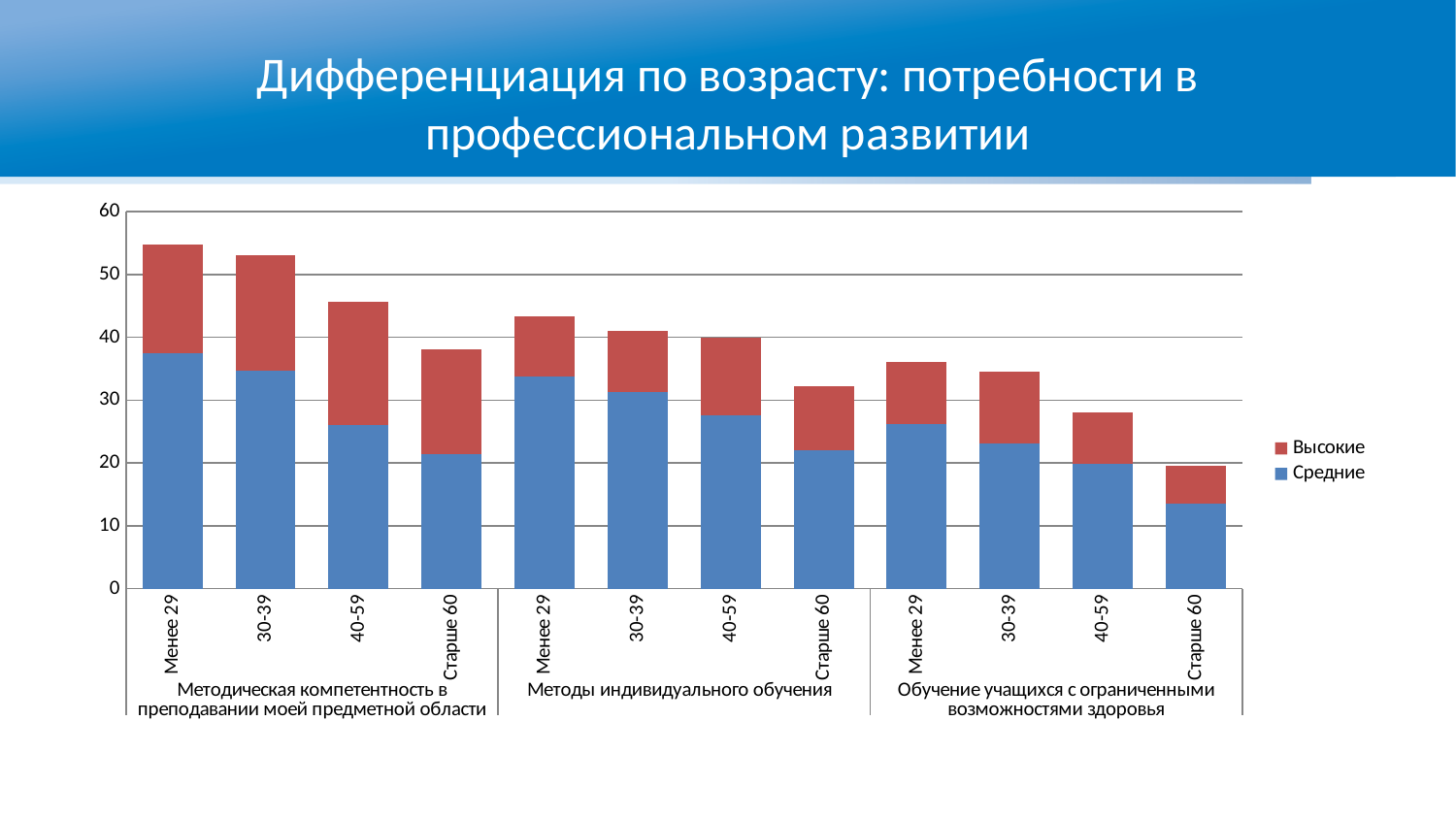
Within each category group, do the total bar heights rise or fall as the age group increases from Менее 29 to Старше 60? fall Is the total height of the bar for Менее 29 in Методическая компетентность в преподавании моей предметной области greater or less than 50? greater How many category groups are shown along the x axis? 3 How many stacked bars are plotted in the chart? 12 Which bar is the shortest in the chart? Старше 60 in Обучение учащихся с ограниченными возможностями здоровья Which colour represents the Средние series in the chart? Blue Which bar is the tallest in the chart? Менее 29 in Методическая компетентность в преподавании моей предметной области Is the Средние value for Старше 60 in Методическая компетентность в преподавании моей предметной области greater or less than 30? less Which bar is taller: Менее 29 in Методы индивидуального обучения or Менее 29 in Обучение учащихся с ограниченными возможностями здоровья? Менее 29 in Методы индивидуального обучения Is the total height of the bar for Старше 60 in Обучение учащихся с ограниченными возможностями здоровья greater or less than 30? less How many series does the legend list? 2 What kind of chart is shown on the slide? Stacked bar chart